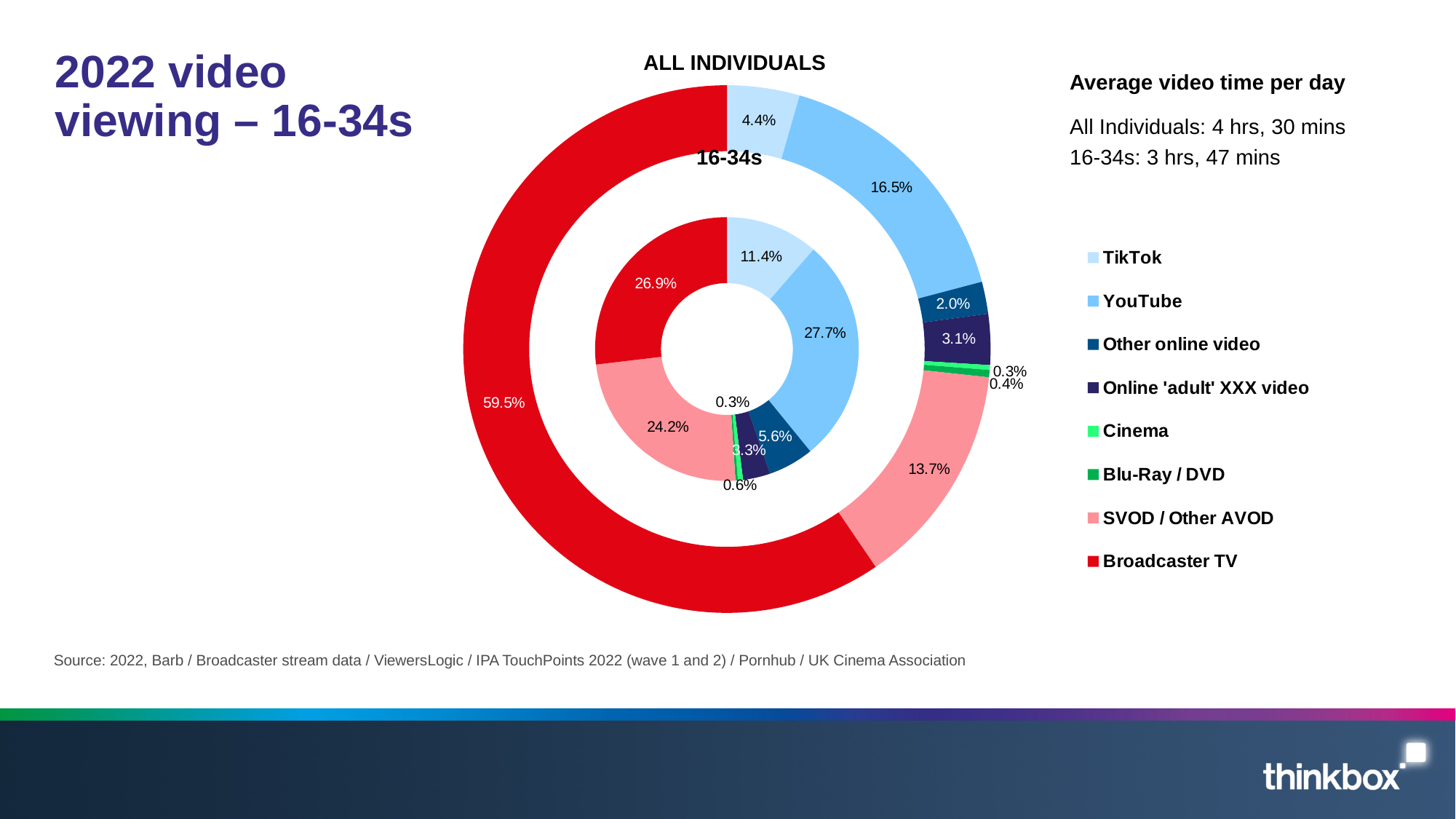
In the 16-34s ring, what share of video viewing is TikTok? 11.4% What kind of chart is shown on the slide? Doughnut chart What is the difference between the Broadcaster TV share for ALL INDIVIDUALS and for 16-34s? 32.6 percentage points What is the difference between the TikTok share for 16-34s and for ALL INDIVIDUALS? 7.0 percentage points In the ALL INDIVIDUALS ring, what share of video viewing is Broadcaster TV? 59.5% How many categories does the legend list? 8 Which is larger for 16-34s: the SVOD / Other AVOD share or the Broadcaster TV share? Broadcaster TV In the 16-34s ring, what share of video viewing is YouTube? 27.7% According to the slide, what is the average video time per day for 16-34s? 3 hrs, 47 mins Which category has the largest share in the 16-34s ring? YouTube Which category has the largest share in the ALL INDIVIDUALS ring? Broadcaster TV In the ALL INDIVIDUALS ring, what share of video viewing is SVOD / Other AVOD? 13.7%